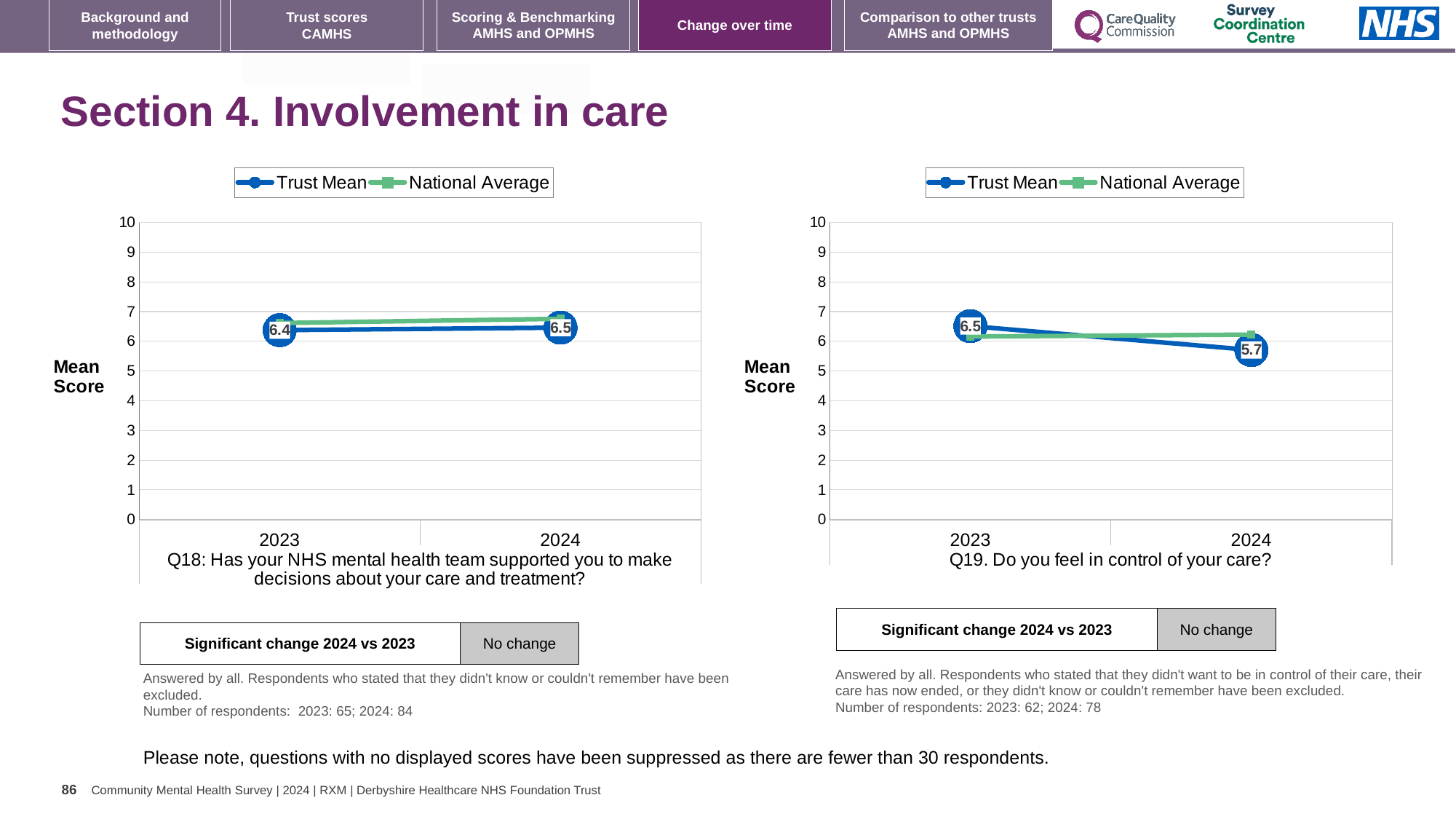
How many series does the legend of the Q19 chart (right) list? 2 In the Q19 chart (right), what is the Trust Mean score for 2024? 5.7 In the Q18 chart (left), does the Trust Mean rise or fall from 2023 to 2024? rise In the Q19 chart (right), what is the Trust Mean score for 2023? 6.5 In the Q19 chart (right), by how much did the Trust Mean change from 2023 to 2024? 0.8 In the Q18 chart (left), what is the Trust Mean score for 2023? 6.4 In the Q19 chart (right), is the National Average for 2024 greater or less than 5? greater In the Q19 chart (right), does the Trust Mean rise or fall from 2023 to 2024? fall In the Q18 chart (left), what is the Trust Mean score for 2024? 6.5 How many years are shown on the x axis of the Q18 chart (left)? 2 In the Q19 chart (right), which series has the higher value in 2024, Trust Mean or National Average? National Average What kind of chart is the Q18 chart on the left? line chart